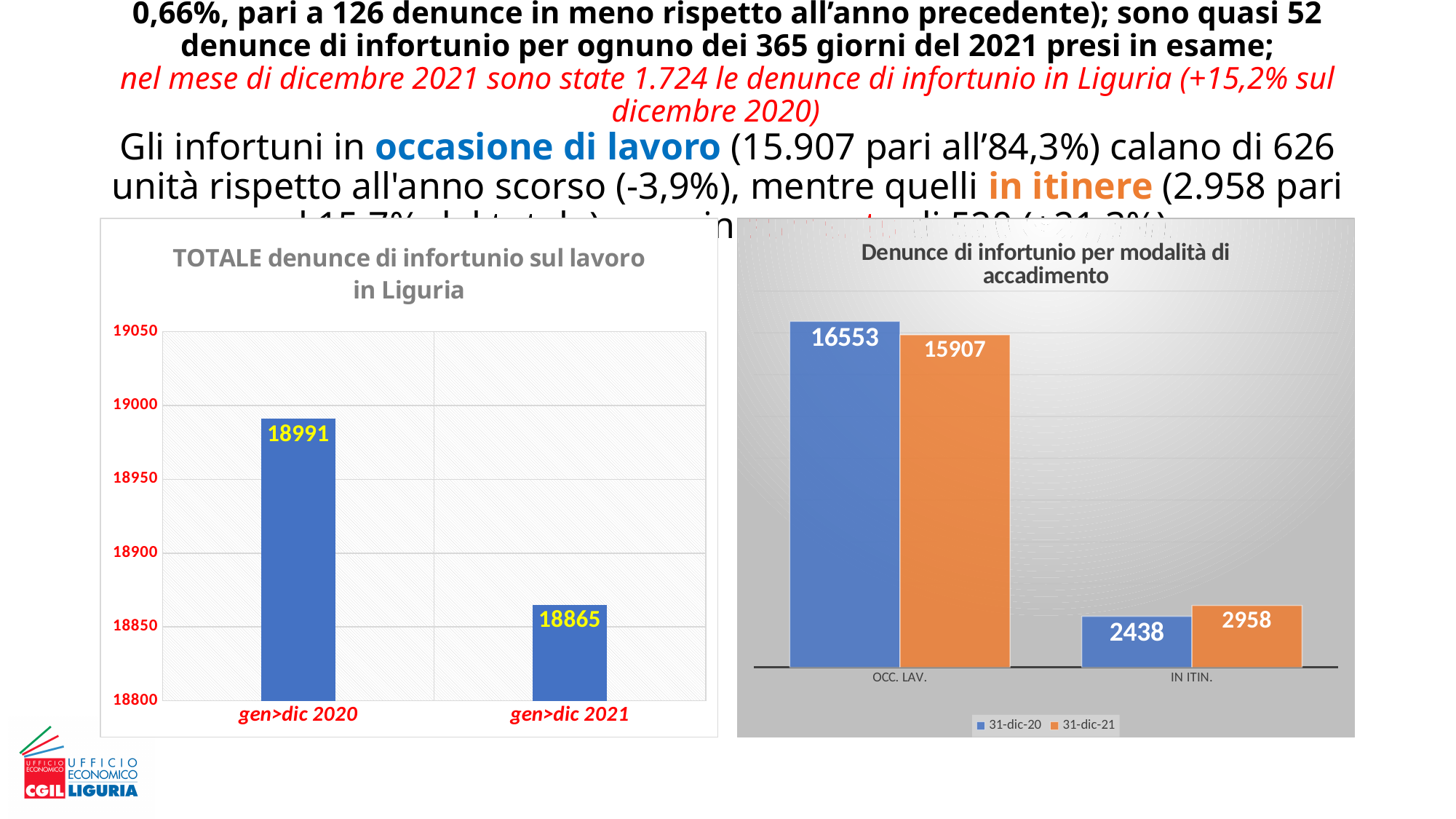
In the chart 'Denunce di infortunio per modalità di accadimento', what colour are the bars for the 31-dic-21 series? orange In the chart 'Denunce di infortunio per modalità di accadimento', what is the value for OCC. LAV. in the 31-dic-21 series? 15907 In the chart 'TOTALE denunce di infortunio sul lavoro in Liguria', what is the value for gen>dic 2020? 18991 In the chart 'TOTALE denunce di infortunio sul lavoro in Liguria', do the values rise or fall from gen>dic 2020 to gen>dic 2021? fall What kind of chart is 'TOTALE denunce di infortunio sul lavoro in Liguria'? bar chart In the chart 'Denunce di infortunio per modalità di accadimento', which is larger for OCC. LAV.: the 31-dic-20 value or the 31-dic-21 value? 31-dic-20 In the chart 'Denunce di infortunio per modalità di accadimento', how many series does the legend list? 2 In the chart 'TOTALE denunce di infortunio sul lavoro in Liguria', what is the difference between the gen>dic 2020 and gen>dic 2021 values? 126 In the chart 'Denunce di infortunio per modalità di accadimento', which category has the highest value in the 31-dic-20 series? OCC. LAV. In the chart 'Denunce di infortunio per modalità di accadimento', what is the difference between the 31-dic-21 and 31-dic-20 values for IN ITIN.? 520 In the chart 'TOTALE denunce di infortunio sul lavoro in Liguria', what is the value for gen>dic 2021? 18865 In the chart 'Denunce di infortunio per modalità di accadimento', what is the value for IN ITIN. in the 31-dic-20 series? 2438